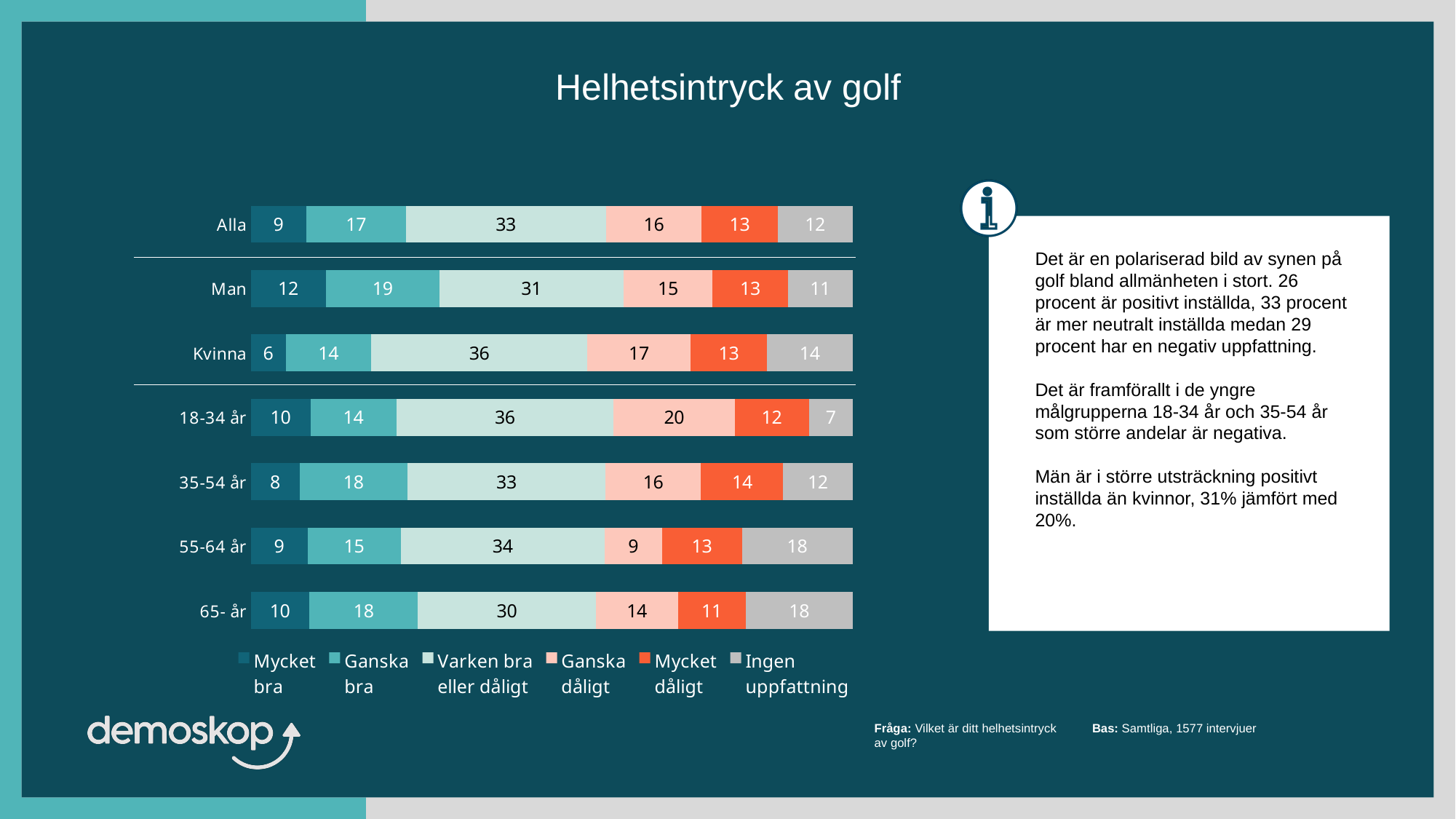
What kind of chart is shown on the slide? Stacked bar chart What is the value for "Ganska dåligt" in the "18-34 år" bar? 20 What is the value for "Varken bra eller dåligt" in the "Kvinna" bar? 36 What is the value for "Mycket bra" in the "Man" bar? 12 What is the title of the chart? Helhetsintryck av golf What is the value for "Ingen uppfattning" in the "55-64 år" bar? 18 What is the difference between the "Mycket bra" values for "Man" and "Kvinna"? 6 Which is larger: the "Ganska bra" value for "Man" or for "18-34 år"? Man How many categories (bars) are shown in the chart? 7 Which category has the highest value for "Ganska dåligt"? 18-34 år How many series does the legend list? 6 Which category has the lowest value for "Mycket bra"? Kvinna